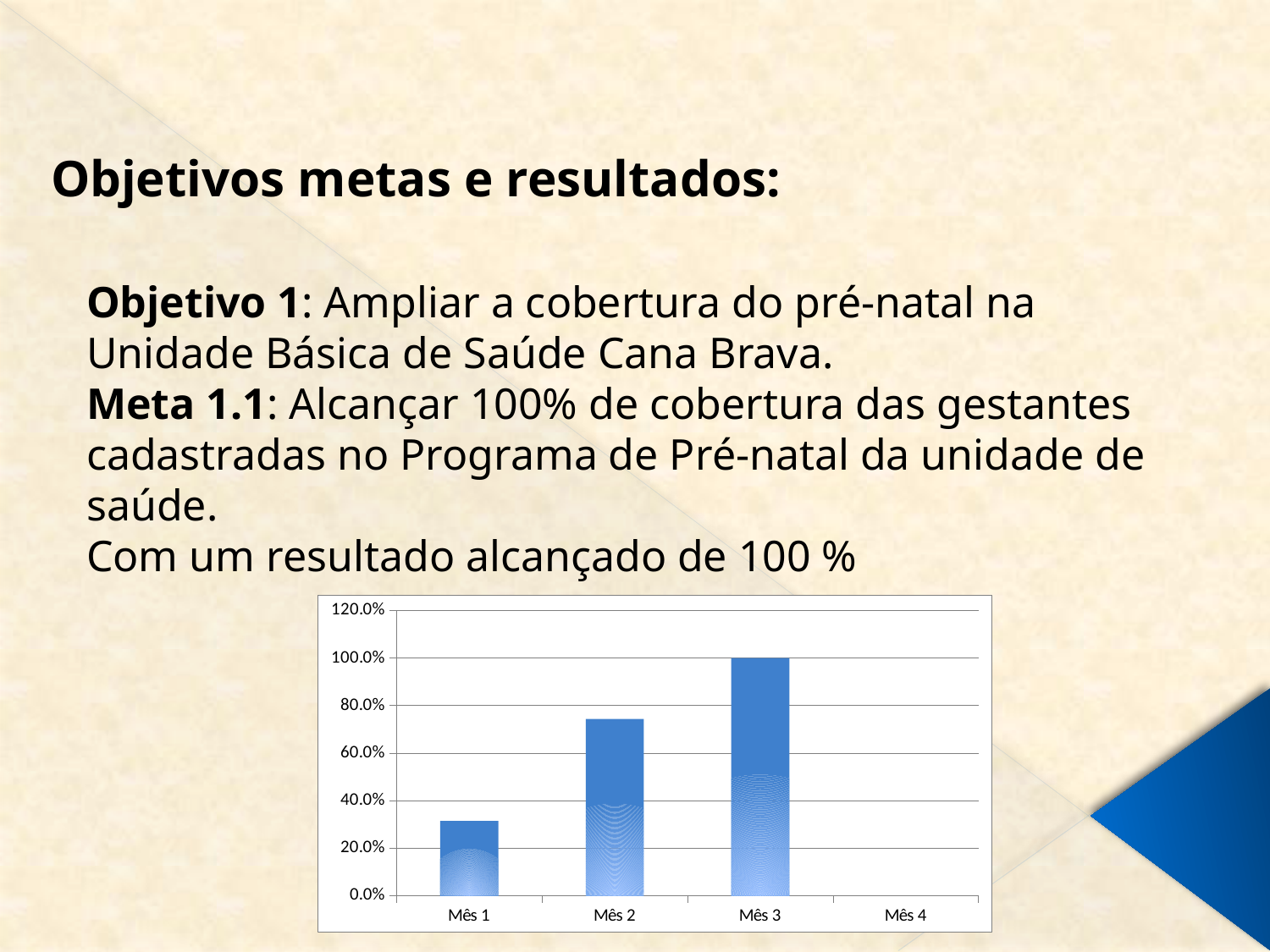
What is the highest value shown on the y axis of the chart? 120.0% Which is larger, the value for Mês 1 or the value for Mês 2? Mês 2 What kind of chart is shown on the slide? bar chart Which month has the highest value in the chart? Mês 3 Is the value for Mês 1 greater or less than 40.0%? less What is the value for Mês 3 in the chart? 100.0% What colour are the bars in the chart? blue Is the value for Mês 2 greater or less than 80.0%? less How many categories are shown on the x axis of the chart? 4 Is the value for Mês 2 greater or less than 60.0%? greater Among Mês 1, Mês 2 and Mês 3, which has the lowest value? Mês 1 Do the values rise or fall from Mês 1 to Mês 3? rise